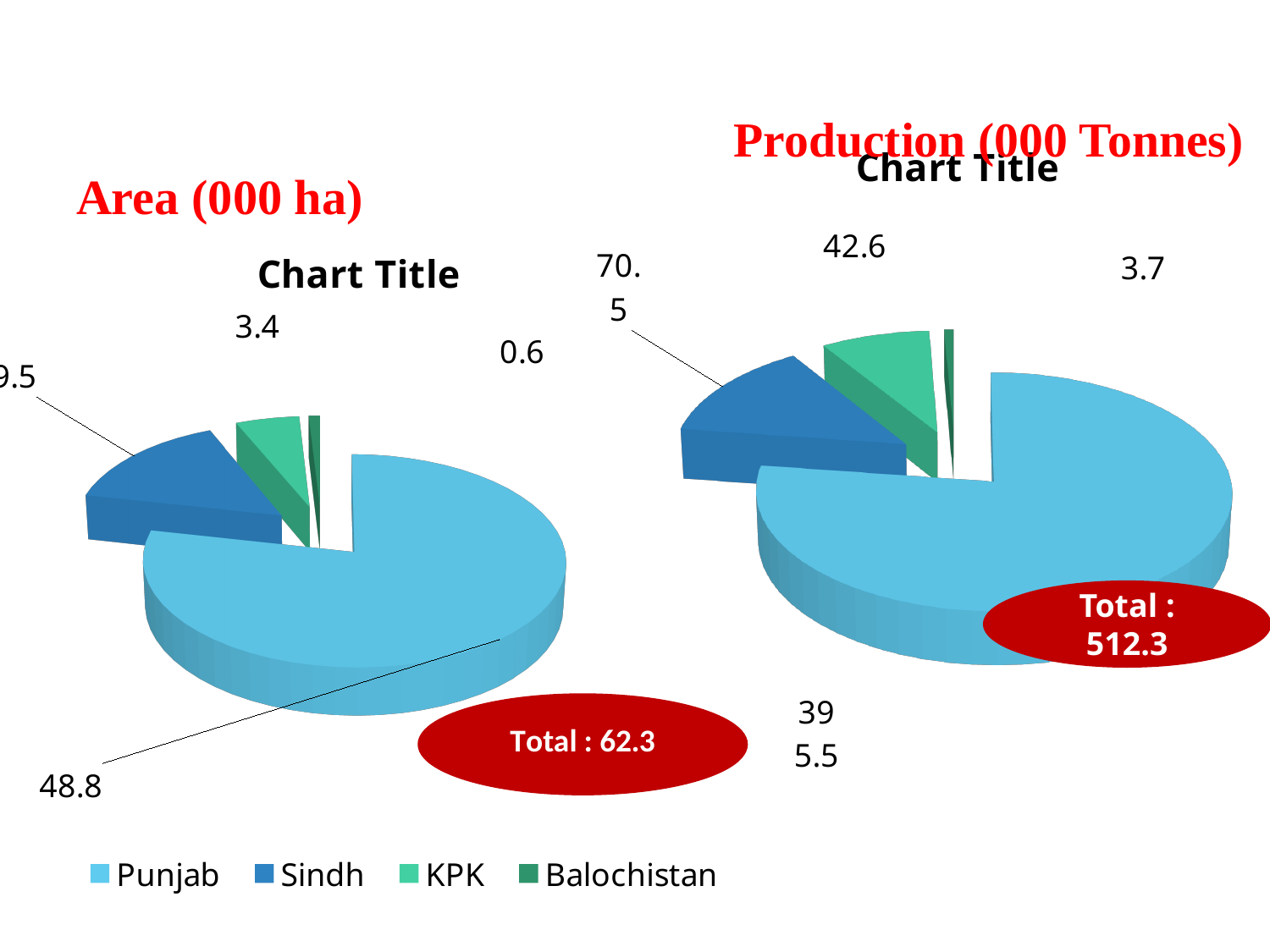
What kind of chart is used for the Area (000 ha) data? Pie chart In the Production (000 Tonnes) chart, what is the value for Balochistan? 3.7 How many provinces does the legend list? 4 In the Area (000 ha) chart, which province has the largest slice? Punjab In the Area (000 ha) chart, which province has the smallest slice? Balochistan What total is shown for the Production (000 Tonnes) chart? 512.3 In the Area (000 ha) chart, what is the value for KPK? 3.4 In the Production (000 Tonnes) chart, which province has the largest slice? Punjab In the Area (000 ha) chart, what is the value for Punjab? 48.8 What total is shown for the Area (000 ha) chart? 62.3 In the Production (000 Tonnes) chart, what is the value for KPK? 42.6 In the Area (000 ha) chart, what is the value for Balochistan? 0.6